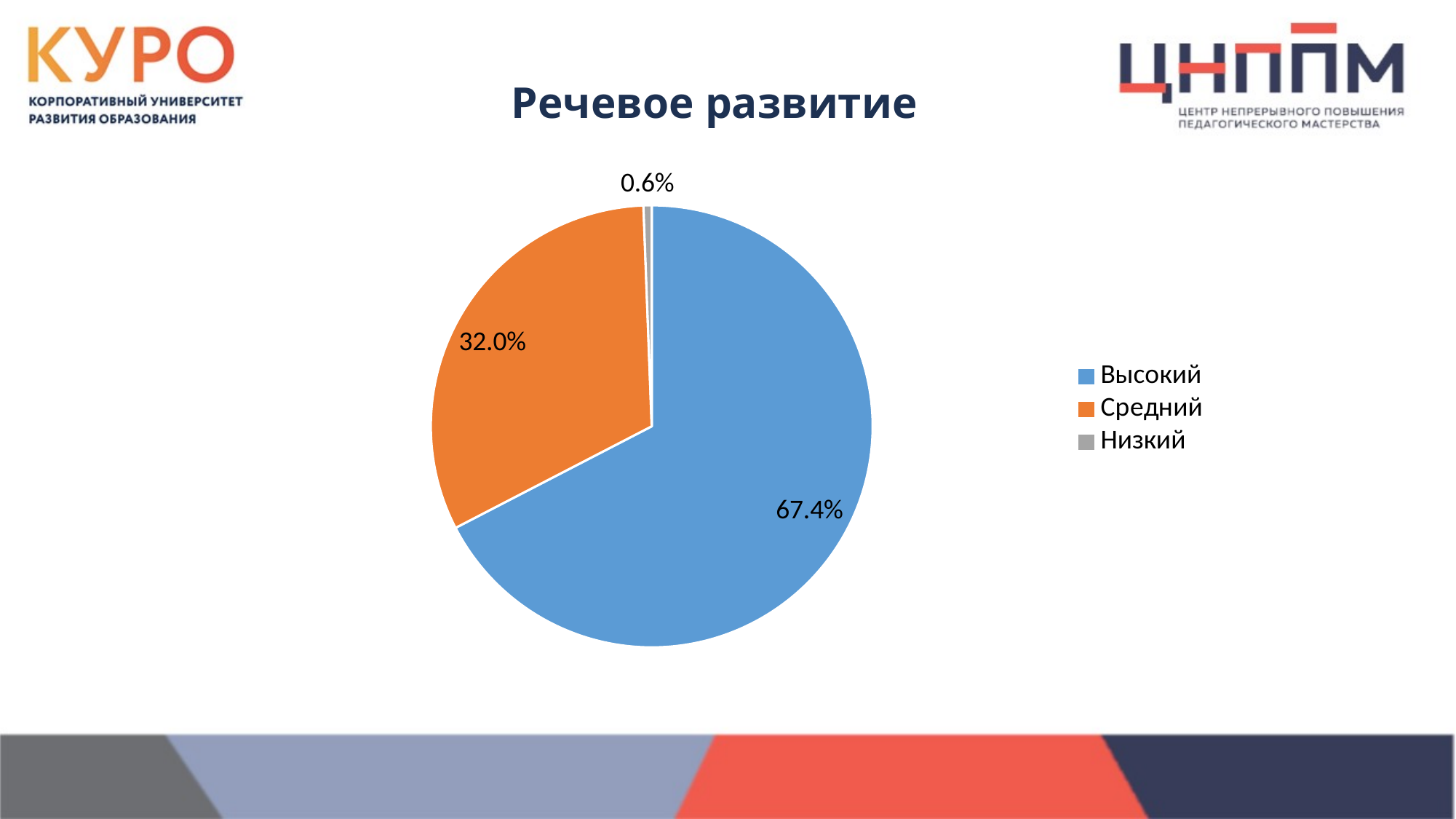
What is the difference between the values for Высокий and Средний? 35.4% What is the title of the chart? Речевое развитие What is the value for Высокий? 67.4% What is the value for Низкий? 0.6% What kind of chart is shown on the slide? pie chart Which is larger, the value for Средний or the value for Низкий? Средний What is the combined share of Средний and Низкий? 32.6% What colour is the slice for Средний? orange Which category has the smallest share of the pie? Низкий How many categories does the pie chart have? 3 What is the value for Средний? 32.0% Which category has the largest share of the pie? Высокий